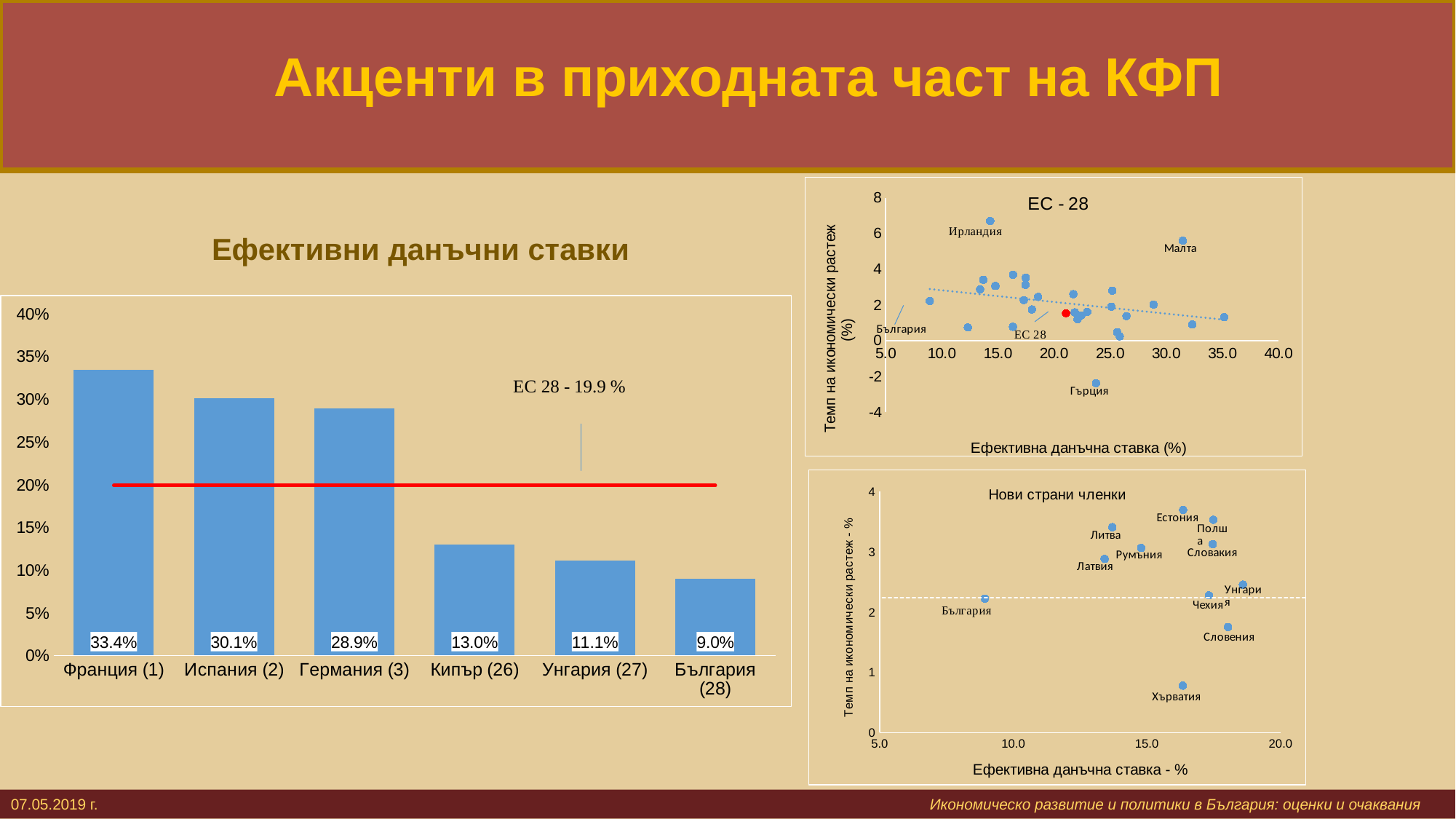
In the chart 'Ефективни данъчни ставки', which is larger: the value for Германия (3) or the value for Кипър (26)? Германия (3) In the chart 'Ефективни данъчни ставки', what is the value for Франция (1)? 33.4% In the chart 'Ефективни данъчни ставки', what is the value for България (28)? 9.0% In the chart 'Ефективни данъчни ставки', which category has the lowest value? България (28) In the chart 'Ефективни данъчни ставки', what is the value for Кипър (26)? 13.0% In the chart 'Ефективни данъчни ставки', what value is given for ЕС 28 by the red reference line? 19.9 % In the chart 'Ефективни данъчни ставки', how many categories are shown on the x axis? 6 In the chart 'ЕС - 28' at the top right, is the value on the vertical axis for Гърция greater or less than 0? less In the chart 'Нови страни членки' at the bottom right, is the value on the vertical axis for Хърватия greater or less than 1? less In the chart 'Ефективни данъчни ставки', what is the difference between the values for Испания (2) and Унгария (27)? 19.0% What kind of chart is 'Ефективни данъчни ставки'? Bar chart In the chart 'Ефективни данъчни ставки', which category has the highest value? Франция (1)